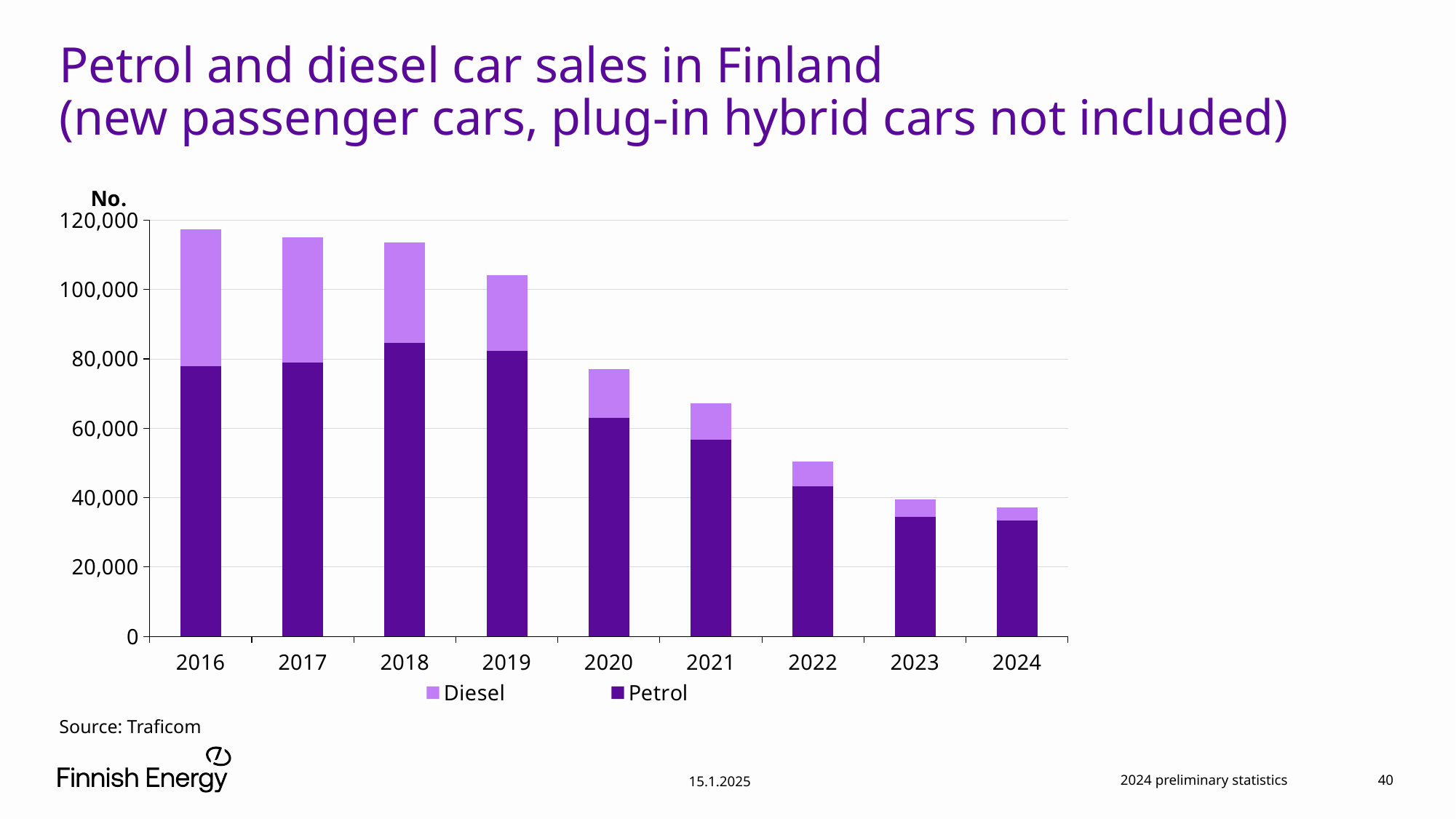
Which is larger, the total bar for 2019 or the total bar for 2022? 2019 Is the total bar for 2020 greater or less than 60,000? greater Is the total bar for 2024 greater or less than 40,000? less Do total petrol and diesel car sales rise or fall from 2016 to 2024? Fall What kind of chart is shown on the slide? Stacked bar chart Is the Petrol value for 2018 greater or less than 80,000? greater How many years are shown on the x axis? 9 How many series does the legend list? 2 Which year has the highest total of petrol and diesel car sales? 2016 Which year has the lowest total of petrol and diesel car sales? 2024 Which series is shown in the lighter purple colour? Diesel